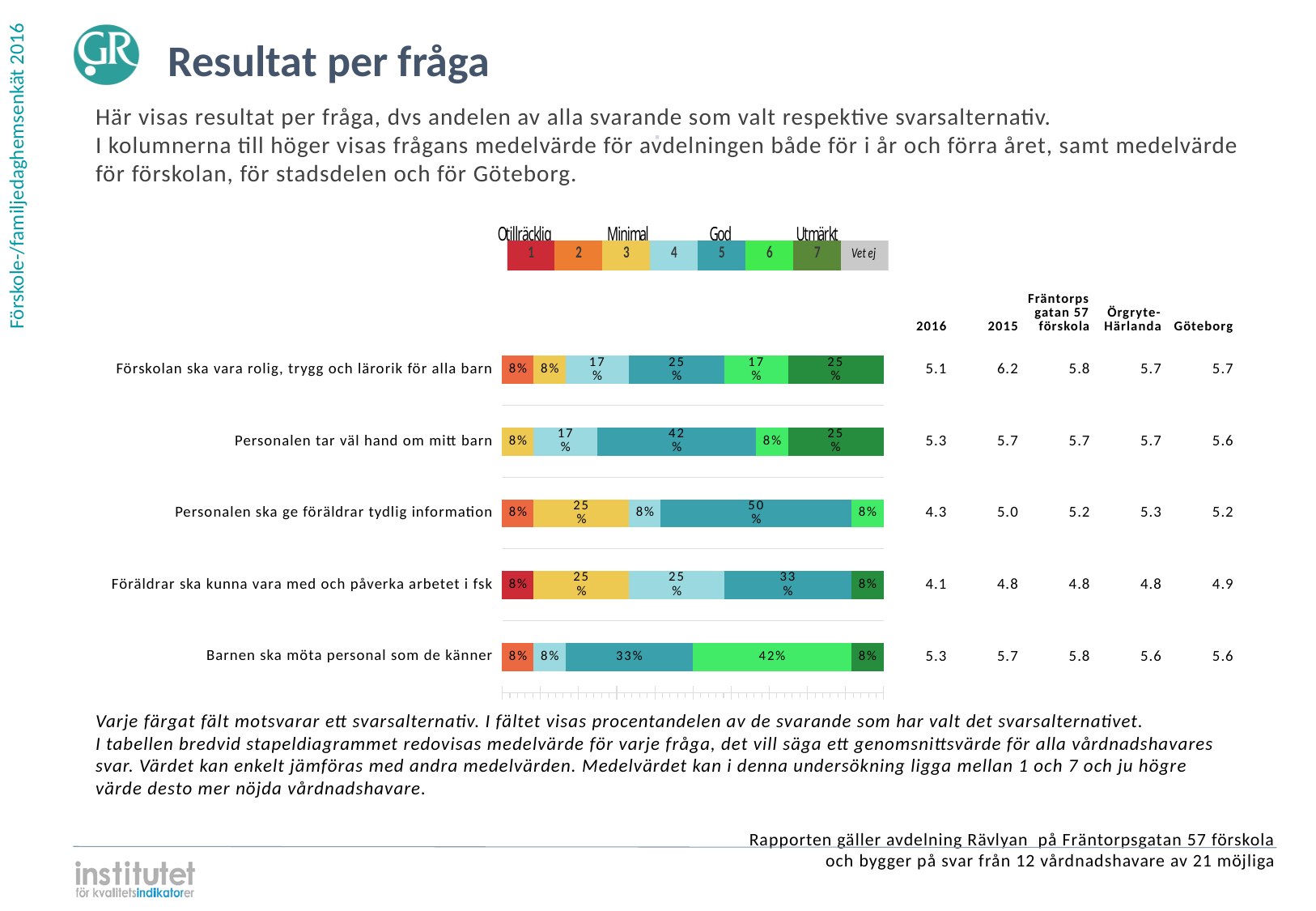
What percentage chose option 7 (dark green) for 'Personalen tar väl hand om mitt barn'? 25% Which answer option has the largest share for 'Personalen tar väl hand om mitt barn'? 5 (42%) What percentage of respondents chose option 5 (teal) for 'Personalen ska ge föräldrar tydlig information'? 50% How many answer options does the legend above the chart list? 8 For 'Förskolan ska vara rolig, trygg och lärorik för alla barn', what is the difference between the share for option 5 and the share for option 4? 8% What label does the legend give to answer option 1? Otillräcklig How many questions (categories) are plotted in the bar chart? 5 What type of chart is shown on the slide? stacked bar chart For 'Barnen ska möta personal som de känner', which is larger: the share for option 5 or the share for option 6? option 6 What percentage chose option 1 (red) for 'Föräldrar ska kunna vara med och påverka arbetet i fsk'? 8% What label does the legend give to answer option 7? Utmärkt What percentage chose option 6 (bright green) for 'Barnen ska möta personal som de känner'? 42%